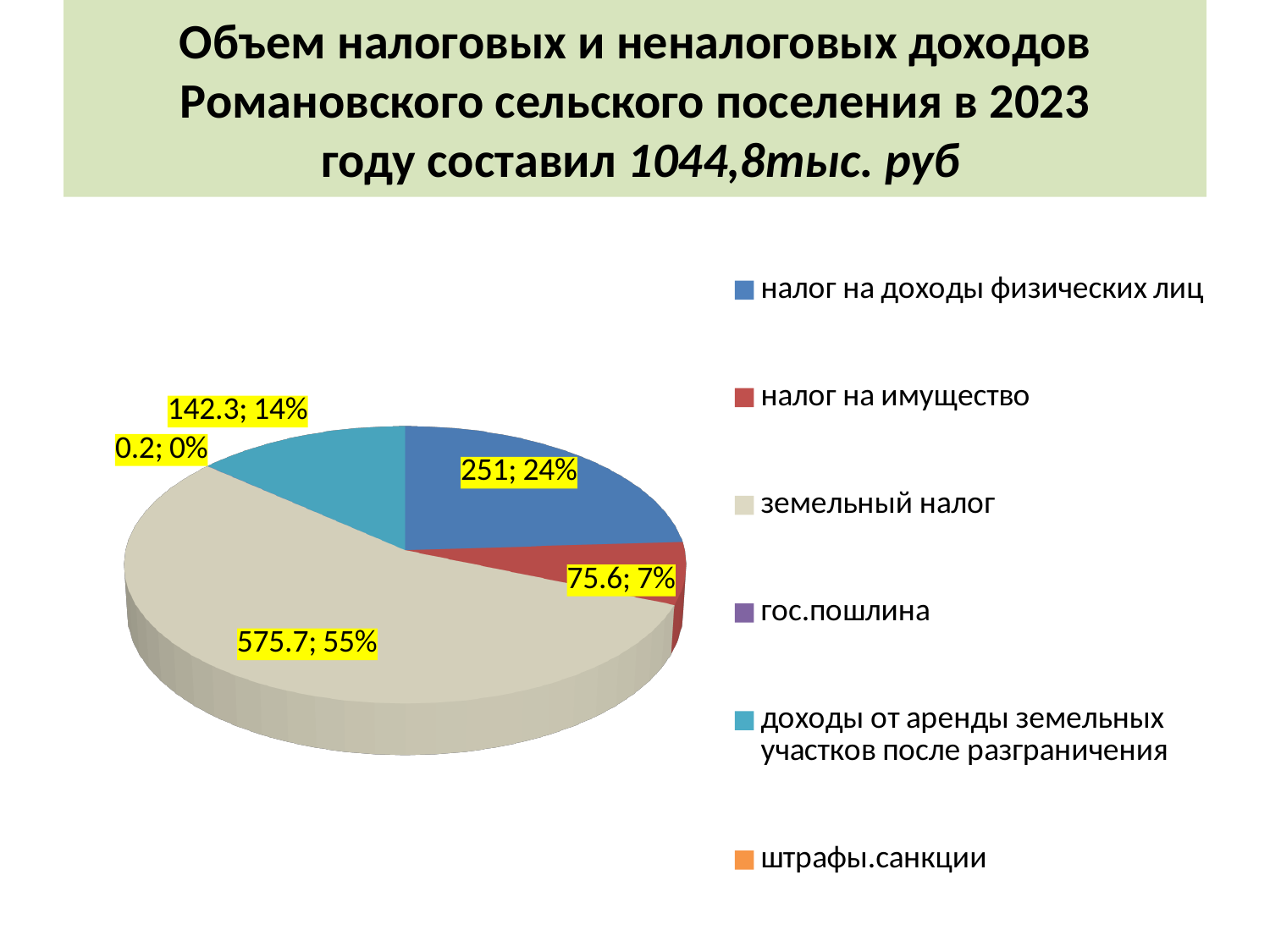
What value is shown for the slice "доходы от аренды земельных участков после разграничения"? 142.3 What share of the pie does "налог на доходы физических лиц" take? 24% What kind of chart is shown on the slide? pie chart What value is shown for the slice "налог на доходы физических лиц"? 251 What value is shown for the slice "налог на имущество"? 75.6 How many entries does the legend list? 6 What share of the pie does "земельный налог" take? 55% What share of the pie does "доходы от аренды земельных участков после разграничения" take? 14% Which is larger: "налог на доходы физических лиц" or "налог на имущество"? налог на доходы физических лиц What is the difference between the values for "земельный налог" and "налог на доходы физических лиц"? 324.7 Which category has the largest slice of the pie? земельный налог What value is shown for the slice "земельный налог"? 575.7